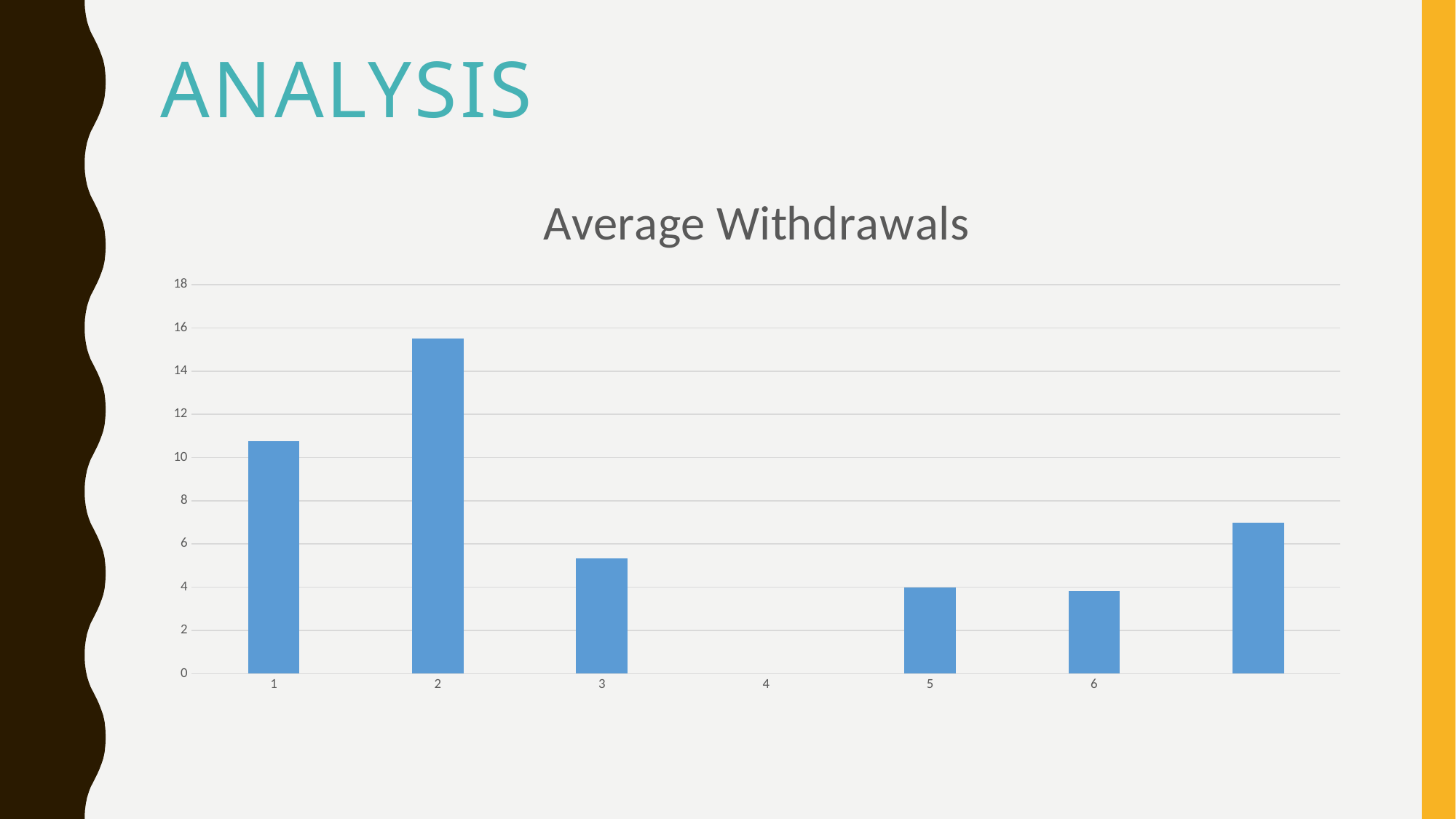
Which category has the highest value in the Average Withdrawals chart? 2 Is the value for category 6 greater or less than 6? less Is the value for category 1 greater or less than 8? greater Which labeled category in the Average Withdrawals chart has no bar shown? 4 Which has the larger value, category 3 or category 5? 3 Which has the larger value, category 1 or category 3? 1 What kind of chart is shown on the slide? bar chart Is the value for category 3 greater or less than 6? less Which has the larger value, category 2 or category 1? 2 What is the title of the chart? Average Withdrawals